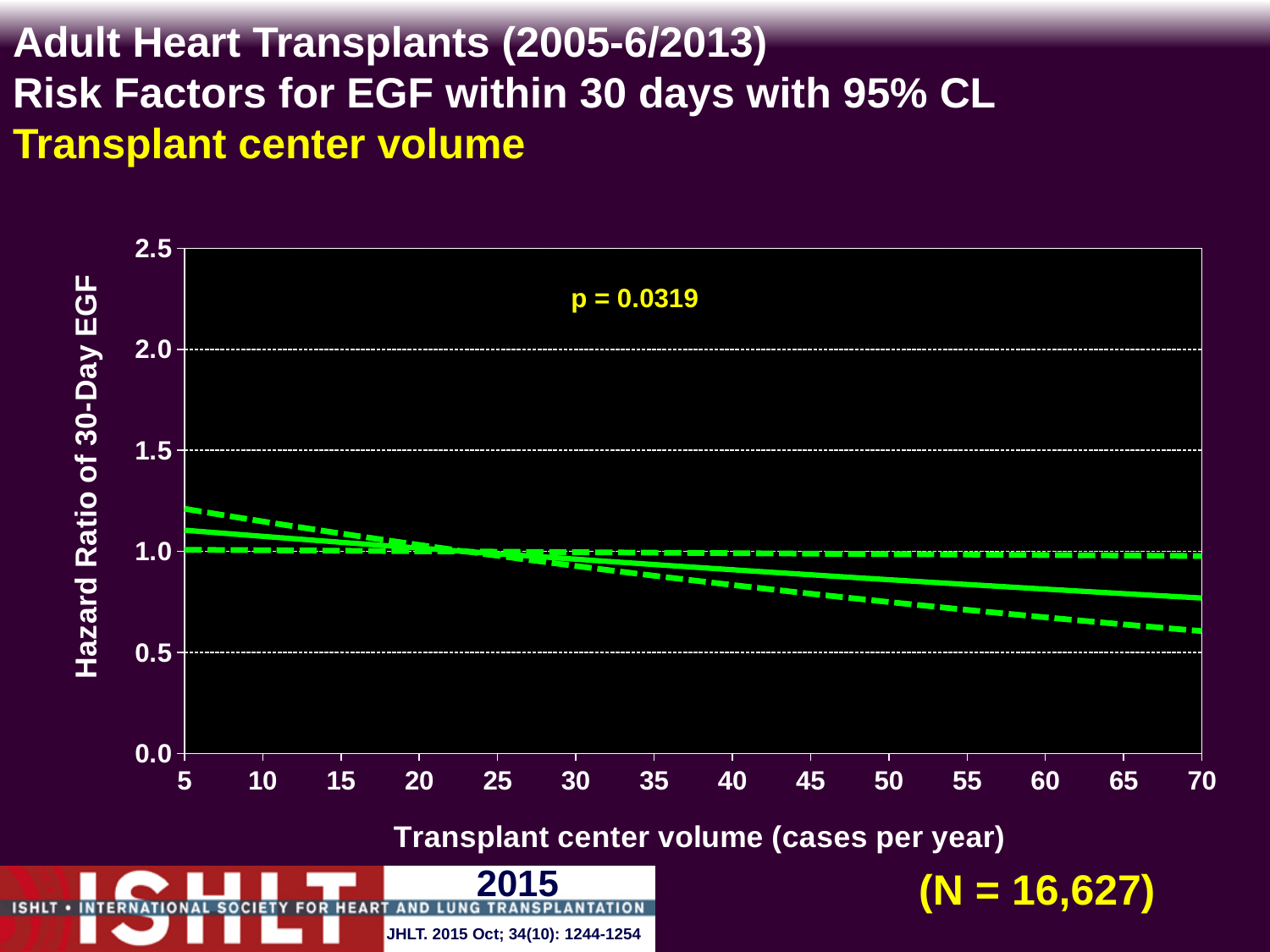
What is the highest value shown on the x-axis? 70 Does the solid hazard ratio line rise or fall as transplant center volume increases from 5 to 70 cases per year? fall What is the p-value printed on the chart? p = 0.0319 What is the highest value shown on the y-axis? 2.5 What is the label of the y-axis? Hazard Ratio of 30-Day EGF What kind of chart is shown on the slide? line chart Is the hazard ratio (solid line) at a transplant center volume of 70 cases per year greater or less than 0.5? greater Is the lower 95% confidence limit (lower dashed line) at a transplant center volume of 70 cases per year greater or less than 0.5? greater Is the upper 95% confidence limit (upper dashed line) at a transplant center volume of 5 cases per year greater or less than 1.0? greater How many lines are plotted on the chart? 3